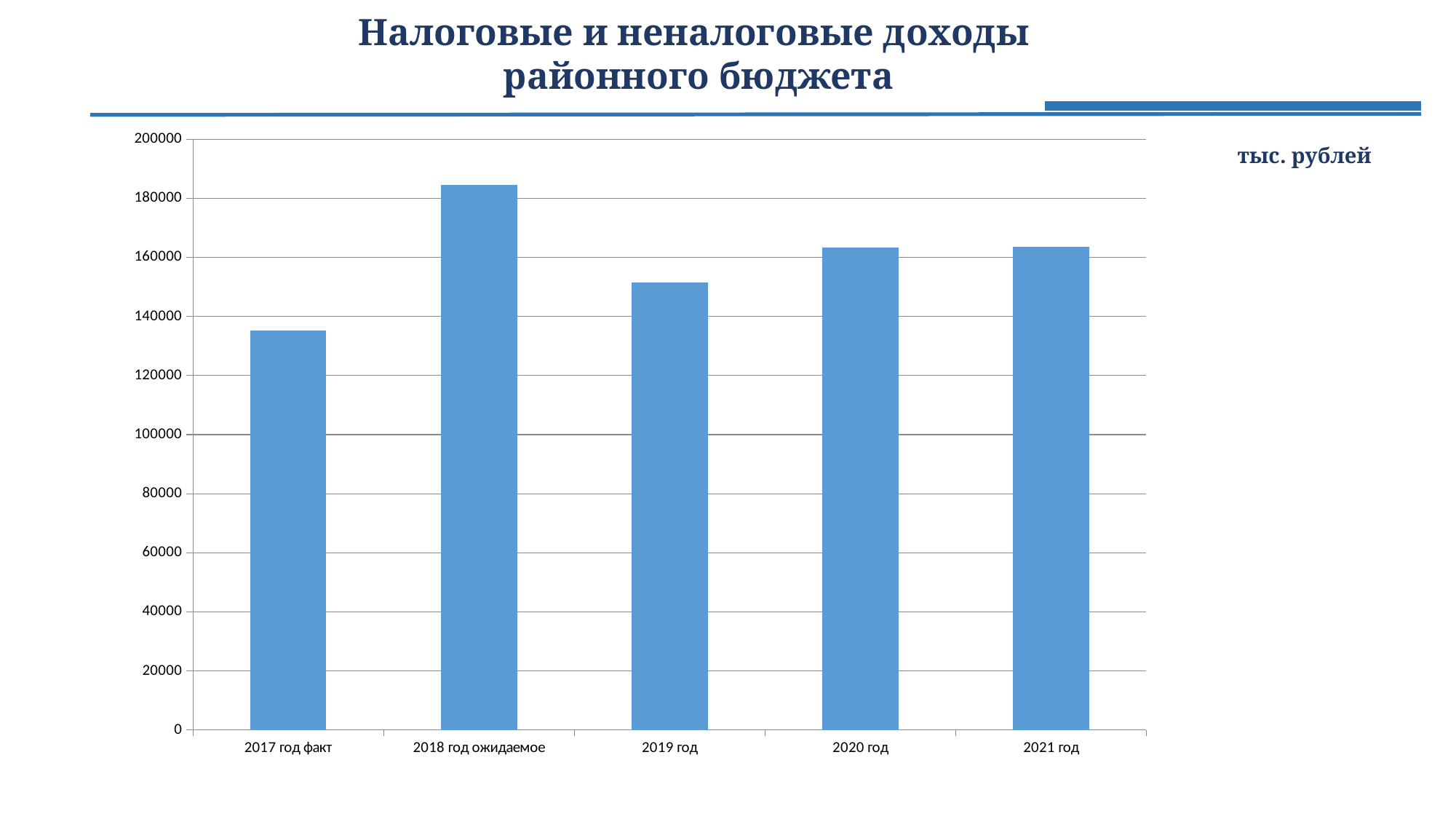
Which category has the lowest value in the chart? 2017 год факт Which is larger, the value for 2019 год or the value for 2021 год? 2021 год Is the value for 2019 год greater or less than 160000? less Which category has the highest value in the chart? 2018 год ожидаемое How many categories are shown on the x axis of the chart? 5 Is the value for 2020 год greater or less than 160000? greater Does the value rise or fall from 2018 год ожидаемое to 2019 год? fall In what units are the values on the chart expressed, according to the slide? тыс. рублей Is the value for 2017 год факт greater or less than 140000? less What is the title of the chart on the slide? Налоговые и неналоговые доходы районного бюджета What kind of chart is shown on the slide? bar chart